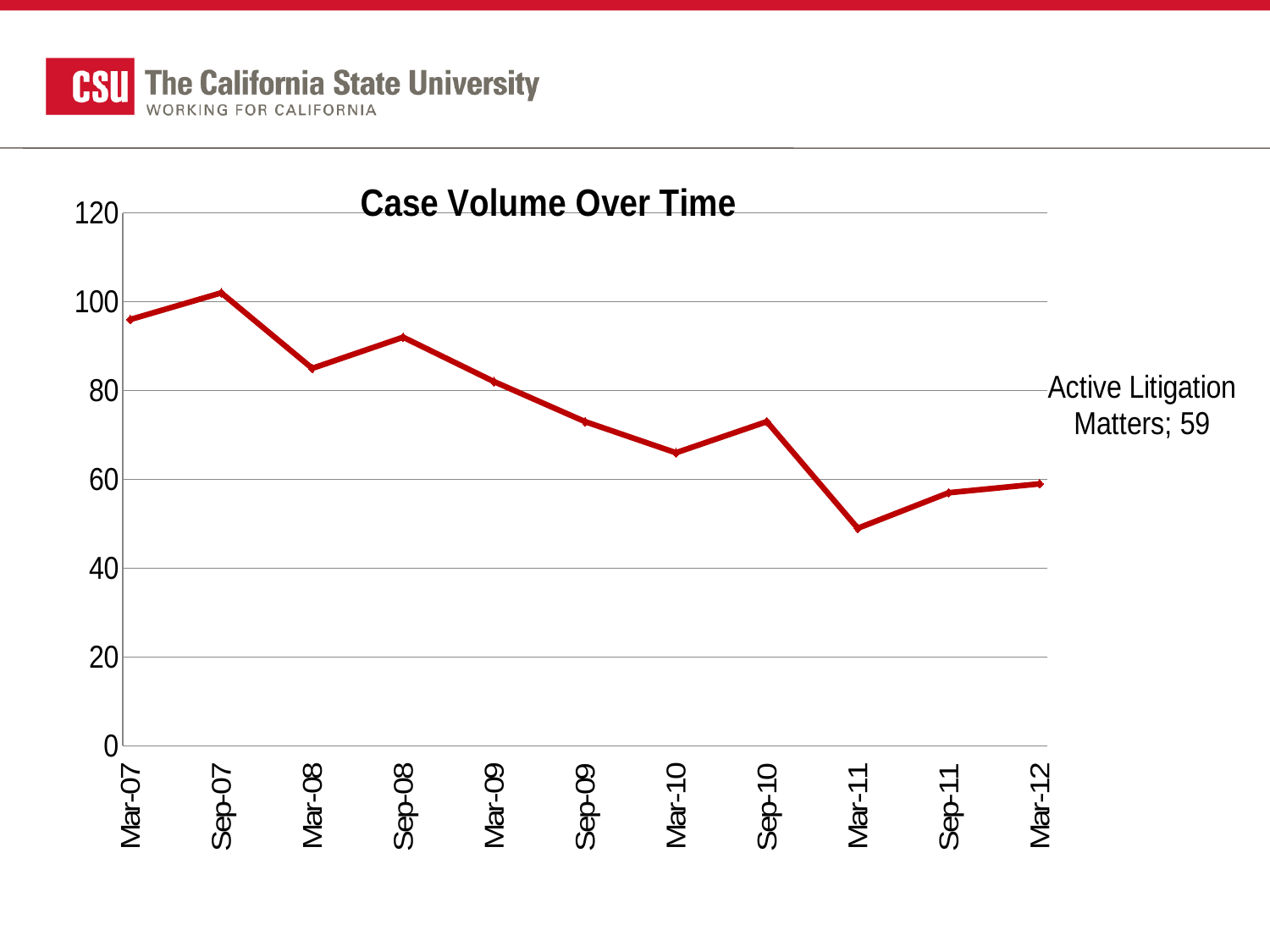
Is the value for Sep-08 greater or less than 80? greater What kind of chart is shown on the slide? line chart Overall, does the case volume rise or fall from Mar-07 to Mar-12? fall What is the value of Active Litigation Matters at Mar-12? 59 Is the value for Mar-10 greater or less than 80? less Is the value for Sep-07 greater or less than 100? greater At which date is the case volume highest? Sep-07 Which is larger, the value for Mar-07 or the value for Mar-12? Mar-07 How many data points are plotted on the line? 11 What is the title of the chart? Case Volume Over Time At which date is the case volume lowest? Mar-11